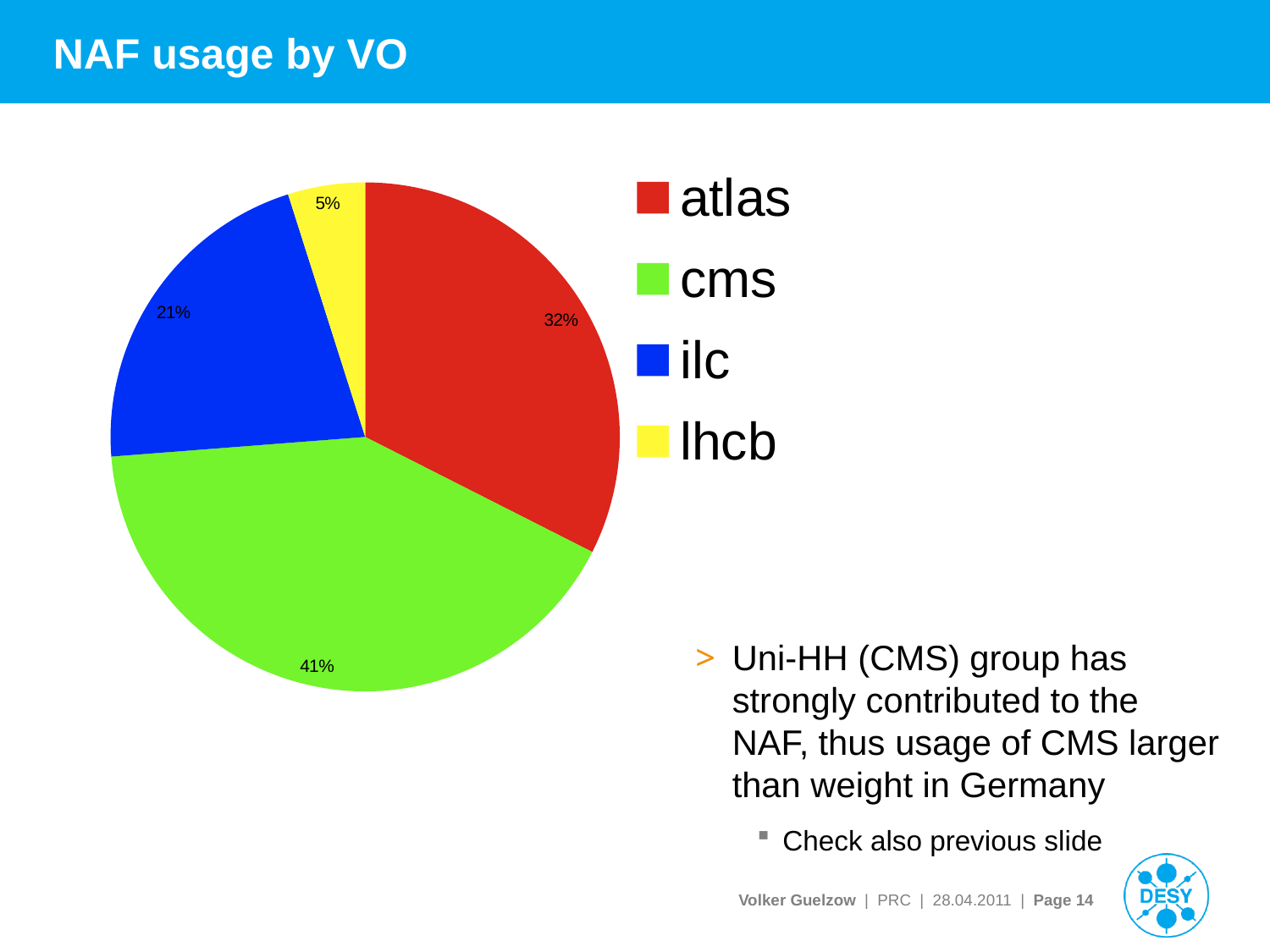
Which has a larger share of NAF usage, atlas or ilc? atlas What share of NAF usage does lhcb have? 5% What kind of chart is shown on the slide? pie chart Which VO has the largest share of NAF usage? cms What colour represents ilc in the pie chart? blue What share of NAF usage does atlas have? 32% Which VO has the smallest share of NAF usage? lhcb How many percentage points larger is the ilc share than the lhcb share? 16 How many percentage points larger is the cms share than the atlas share? 9 What share of NAF usage does cms have? 41% How many VOs are shown in the pie chart? 4 What share of NAF usage does ilc have? 21%